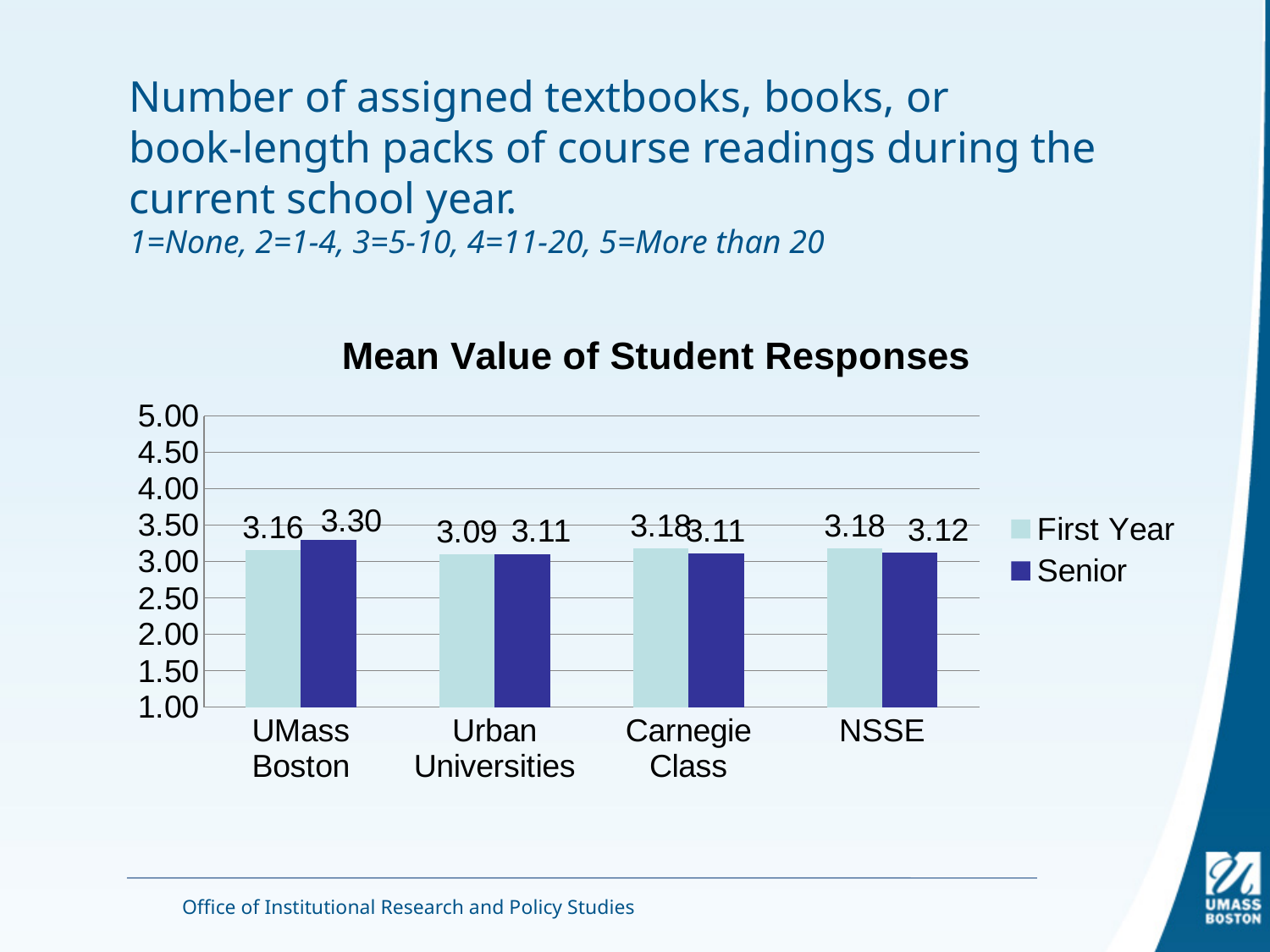
What is the difference between the Senior and First Year values for UMass Boston? 0.14 What is the Senior value for UMass Boston? 3.30 Is the Senior value for UMass Boston greater or less than 3.00? greater Which category has the highest Senior value? UMass Boston What is the Senior value for NSSE? 3.12 What is the First Year value for Urban Universities? 3.09 Which category has the lowest First Year value? Urban Universities How many categories are shown on the x axis? 4 What kind of chart is shown on the slide? bar chart How many series does the legend list? 2 What is the title of the chart? Mean Value of Student Responses What is the First Year value for UMass Boston? 3.16